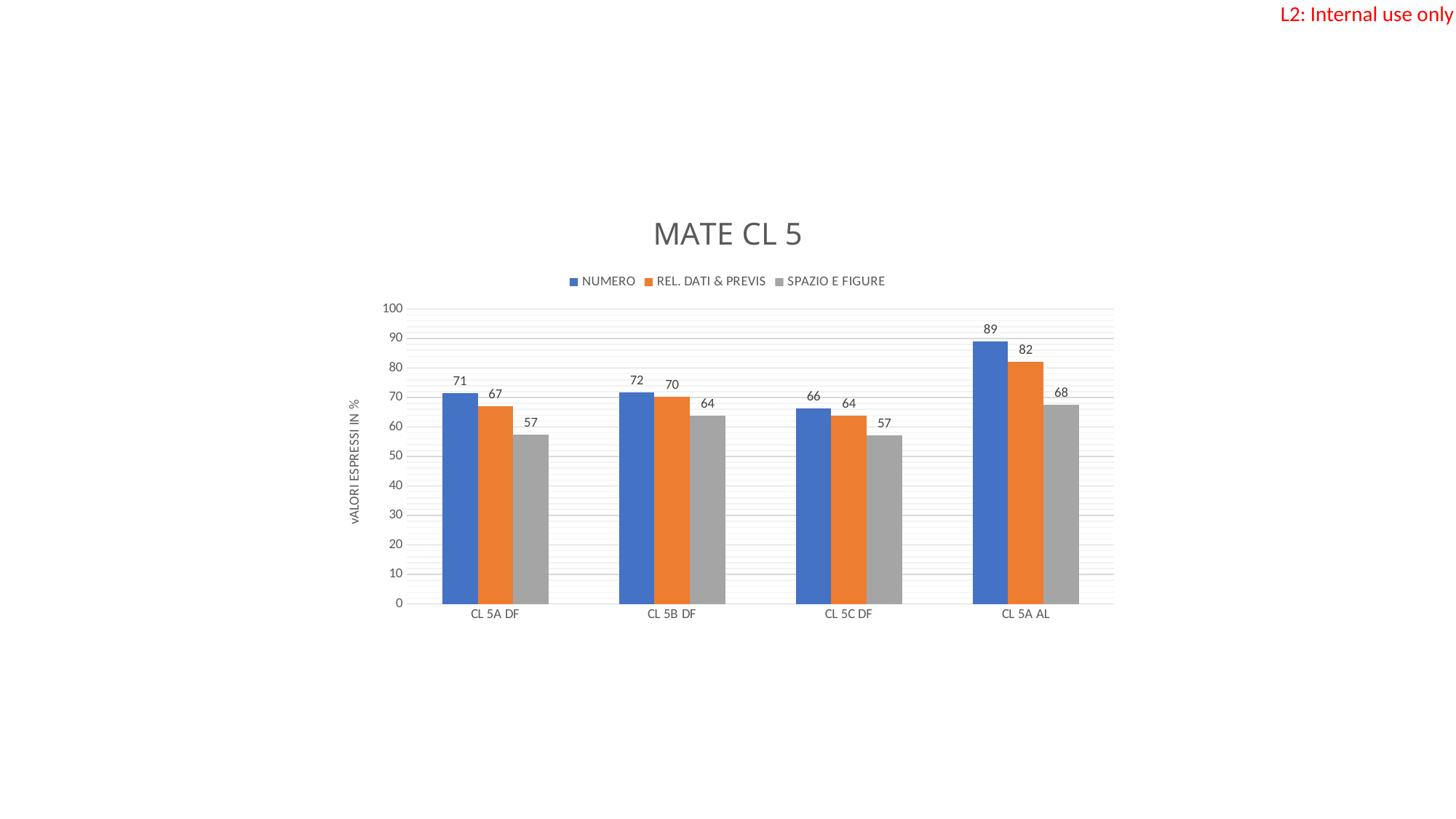
What is the NUMERO value for CL 5A AL? 89 Is the REL. DATI & PREVIS value for CL 5A AL greater or less than 80? greater Which category has the highest NUMERO value? CL 5A AL What is the difference between the NUMERO and SPAZIO E FIGURE values for CL 5A AL? 21 What is the title of the chart? MATE CL 5 What is the REL. DATI & PREVIS value for CL 5C DF? 64 How many series does the legend list? 3 Which is larger for CL 5B DF: NUMERO or SPAZIO E FIGURE? NUMERO Which category has the lowest REL. DATI & PREVIS value? CL 5C DF How many categories are shown on the x axis? 4 What kind of chart is shown? bar chart What is the SPAZIO E FIGURE value for CL 5B DF? 64